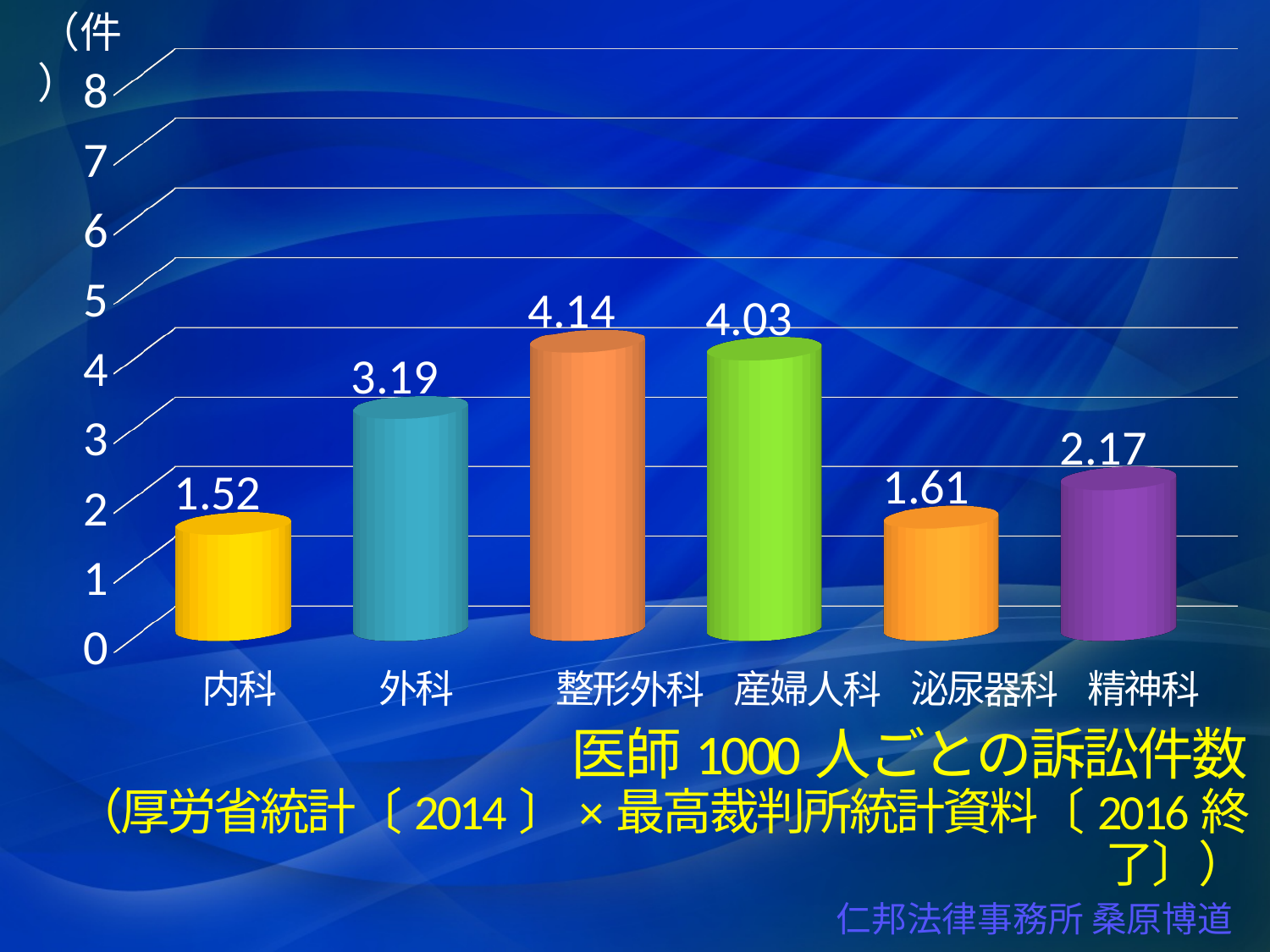
What is the difference between the values for 整形外科 and 産婦人科? 0.11 Is the value for 外科 greater or less than 3? greater How many categories are shown on the x axis? 6 Which category has the lowest value? 内科 What is the value for 精神科? 2.17 What unit is shown on the vertical axis? 件 Which category has the highest value? 整形外科 Which is larger, the value for 精神科 or the value for 泌尿器科? 精神科 What is the difference between the values for 外科 and 泌尿器科? 1.58 What kind of chart is shown on the slide? bar chart What is the value for 整形外科? 4.14 What is the value for 内科? 1.52